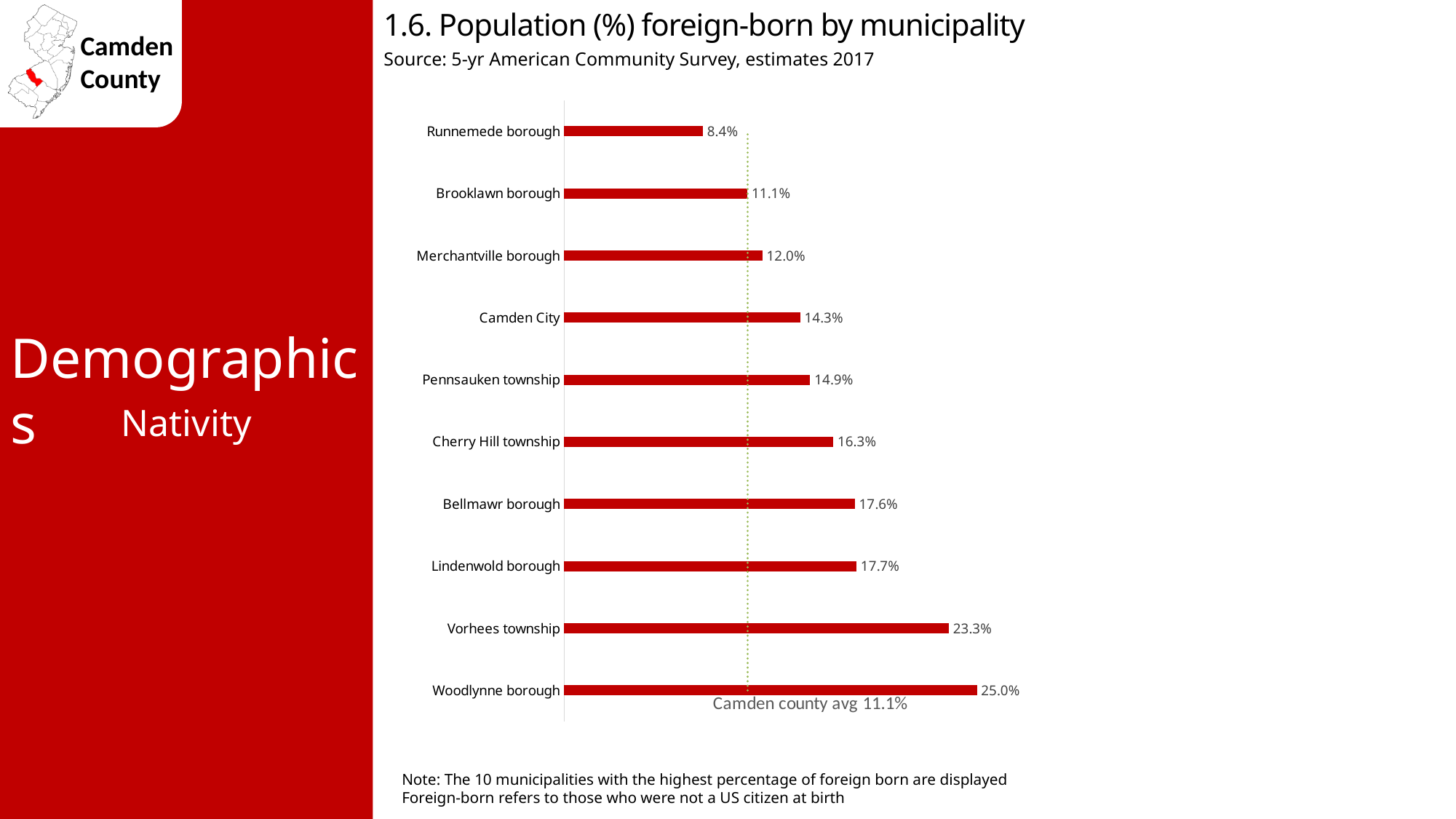
What type of chart is used to show the foreign-born population by municipality? Bar chart Which municipality has the highest percentage of foreign-born population? Woodlynne borough What is the source of the data shown in the chart? 5-yr American Community Survey, estimates 2017 What is the percentage of foreign-born population for Camden City? 14.3% What is the percentage of foreign-born population for Woodlynne borough? 25.0% What is the percentage of foreign-born population for Cherry Hill township? 16.3% Which municipality has the lowest percentage of foreign-born population? Runnemede borough What is the difference in percentage points between Woodlynne borough and Vorhees township? 1.7 Which has a higher percentage of foreign-born population, Bellmawr borough or Merchantville borough? Bellmawr borough How many municipalities are shown in the chart? 10 What is the difference in percentage points between Pennsauken township and Runnemede borough? 6.5 What is the Camden county average percentage of foreign-born population shown by the dotted line? 11.1%